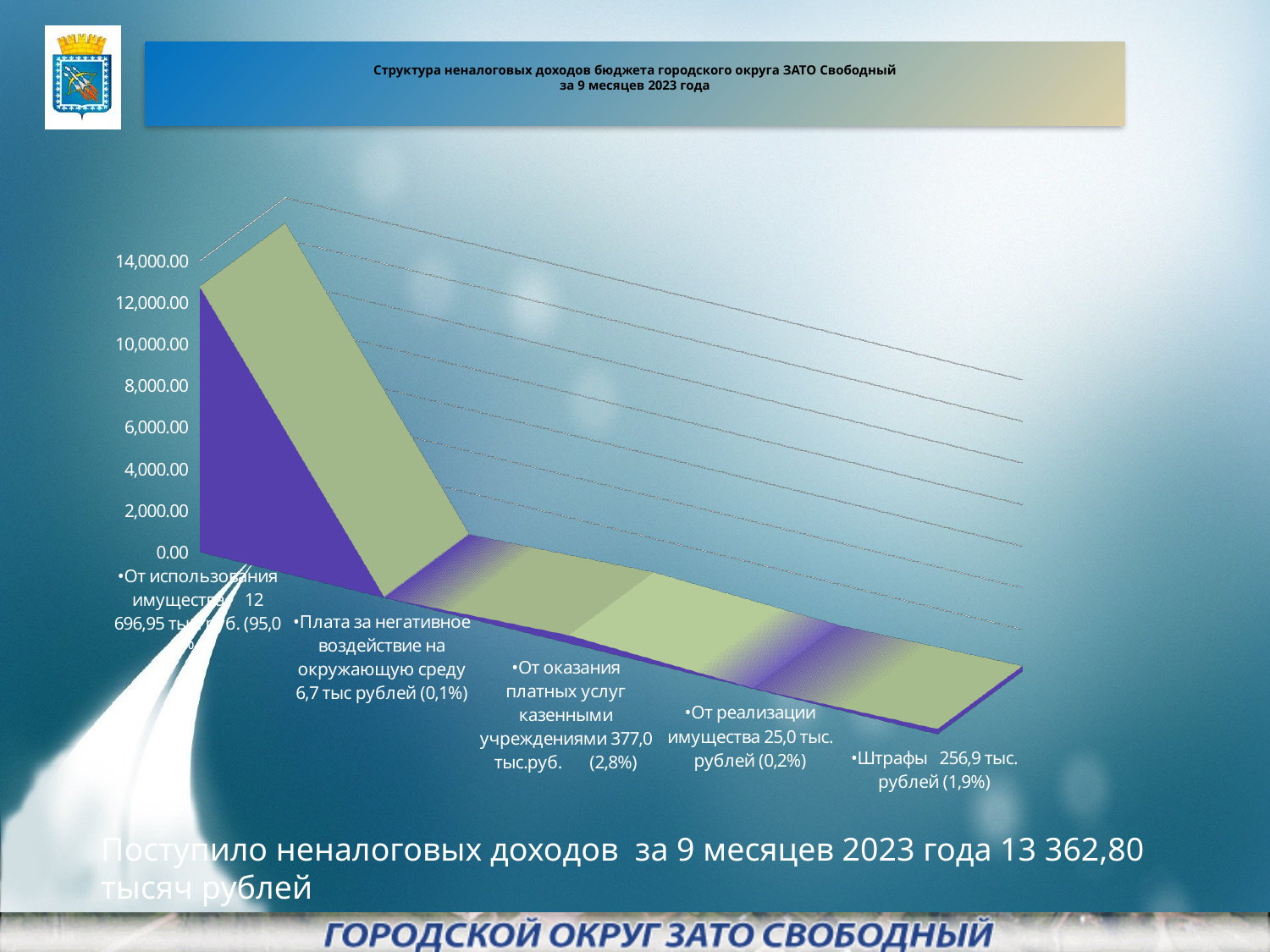
How many categories are plotted on the chart? 5 What is the difference between the value for 'От оказания платных услуг казенными учреждениями' (377,0) and the value for 'Штрафы' (256,9), in тыс. руб.? 120,1 What value is given for 'От оказания платных услуг казенными учреждениями'? 377,0 тыс.руб. (2,8%) Is the value for 'От использования имущества' greater or less than 12,000.00? greater Which category has the highest value on the chart? От использования имущества Which is larger: the value for 'Штрафы' or the value for 'От реализации имущества'? Штрафы What value is given for 'Штрафы'? 256,9 тыс. рублей (1,9%) What value is given for 'От реализации имущества'? 25,0 тыс. рублей (0,2%) What kind of chart is shown on the slide? area chart Which category has the lowest value on the chart? Плата за негативное воздействие на окружающую среду What value is given for 'Плата за негативное воздействие на окружающую среду'? 6,7 тыс рублей (0,1%) What is the title of the chart? Структура неналоговых доходов бюджета городского округа ЗАТО Свободный за 9 месяцев 2023 года